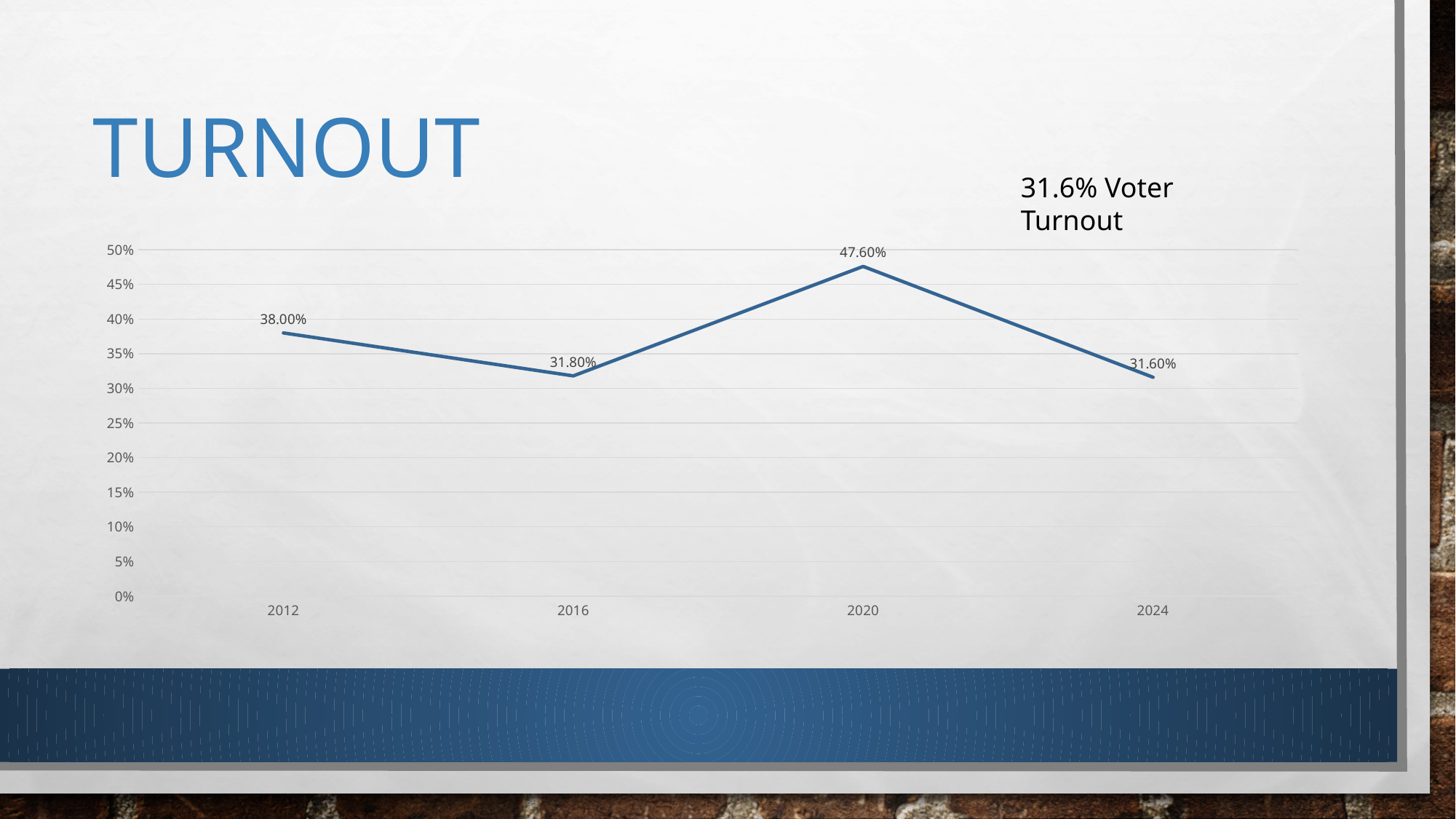
Does the turnout rise or fall from 2020 to 2024? fall Which year has the highest turnout? 2020 What kind of chart is shown on the slide? line chart What is the difference between the turnout in 2020 and the turnout in 2012? 9.60% What is the turnout value for 2016? 31.80% What is the turnout value for 2012? 38.00% What is the turnout value for 2024? 31.60% What is the turnout value for 2020? 47.60% Which is larger, the turnout in 2012 or the turnout in 2024? 2012 How many years are plotted on the chart? 4 Which year has the lowest turnout? 2024 Is the value for 2020 greater or less than 45%? greater